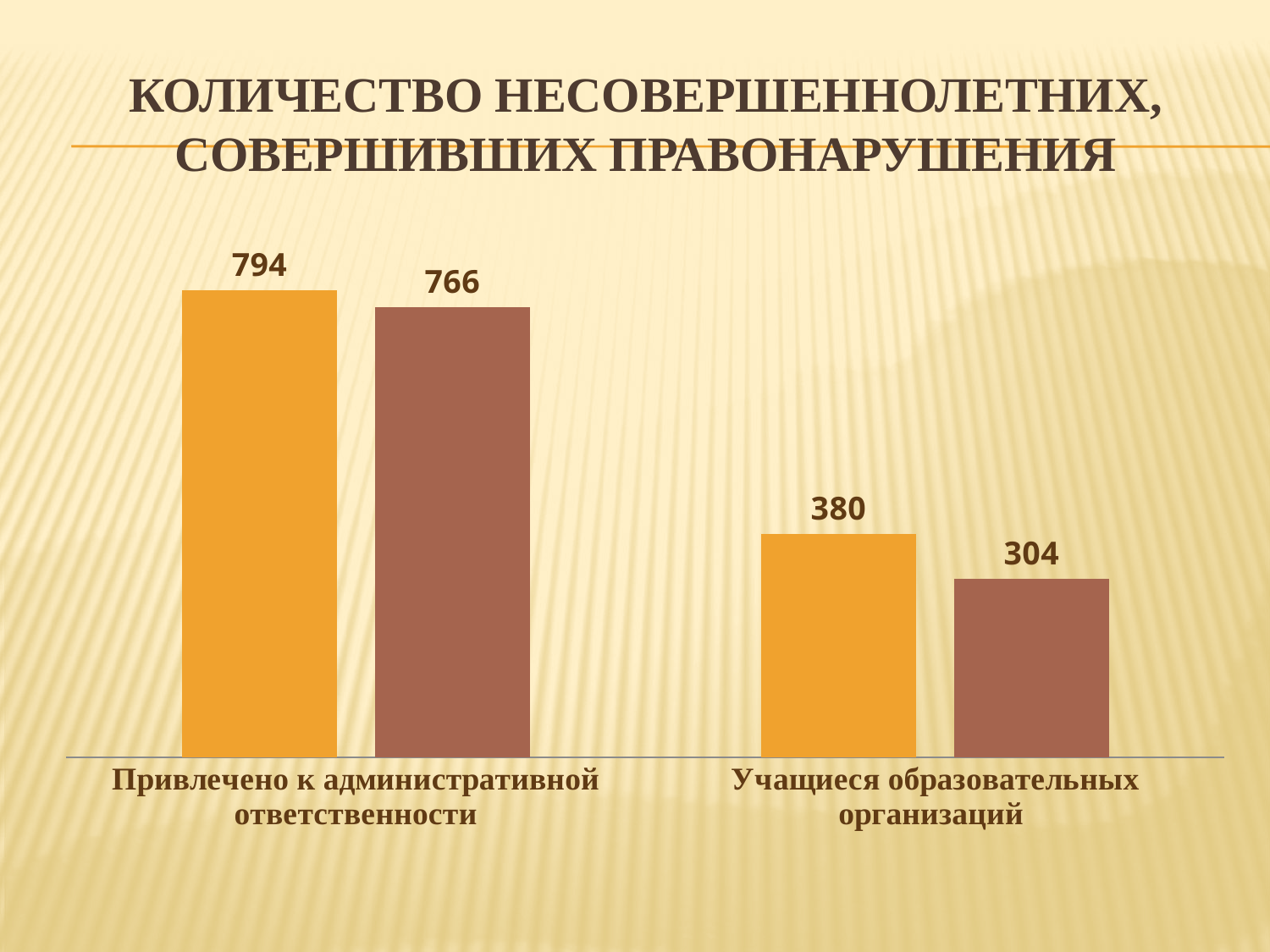
What kind of chart is shown on the slide? bar chart What is the difference between the orange and brown bars for "Привлечено к административной ответственности"? 28 What is the value of the orange bar for "Учащиеся образовательных организаций"? 380 Which bar has the highest value on the chart? the orange bar for Привлечено к административной ответственности (794) What is the title of the chart on the slide? Количество несовершеннолетних, совершивших правонарушения What is the difference between the orange and brown bars for "Учащиеся образовательных организаций"? 76 What is the value of the orange bar for "Привлечено к административной ответственности"? 794 What is the value of the brown bar for "Учащиеся образовательных организаций"? 304 Which is larger: the orange bar for "Учащиеся образовательных организаций" or the brown bar for the same category? the orange bar (380) What is the value of the brown bar for "Привлечено к административной ответственности"? 766 Which bar has the lowest value on the chart? the brown bar for Учащиеся образовательных организаций (304) How many categories are shown on the x axis? 2